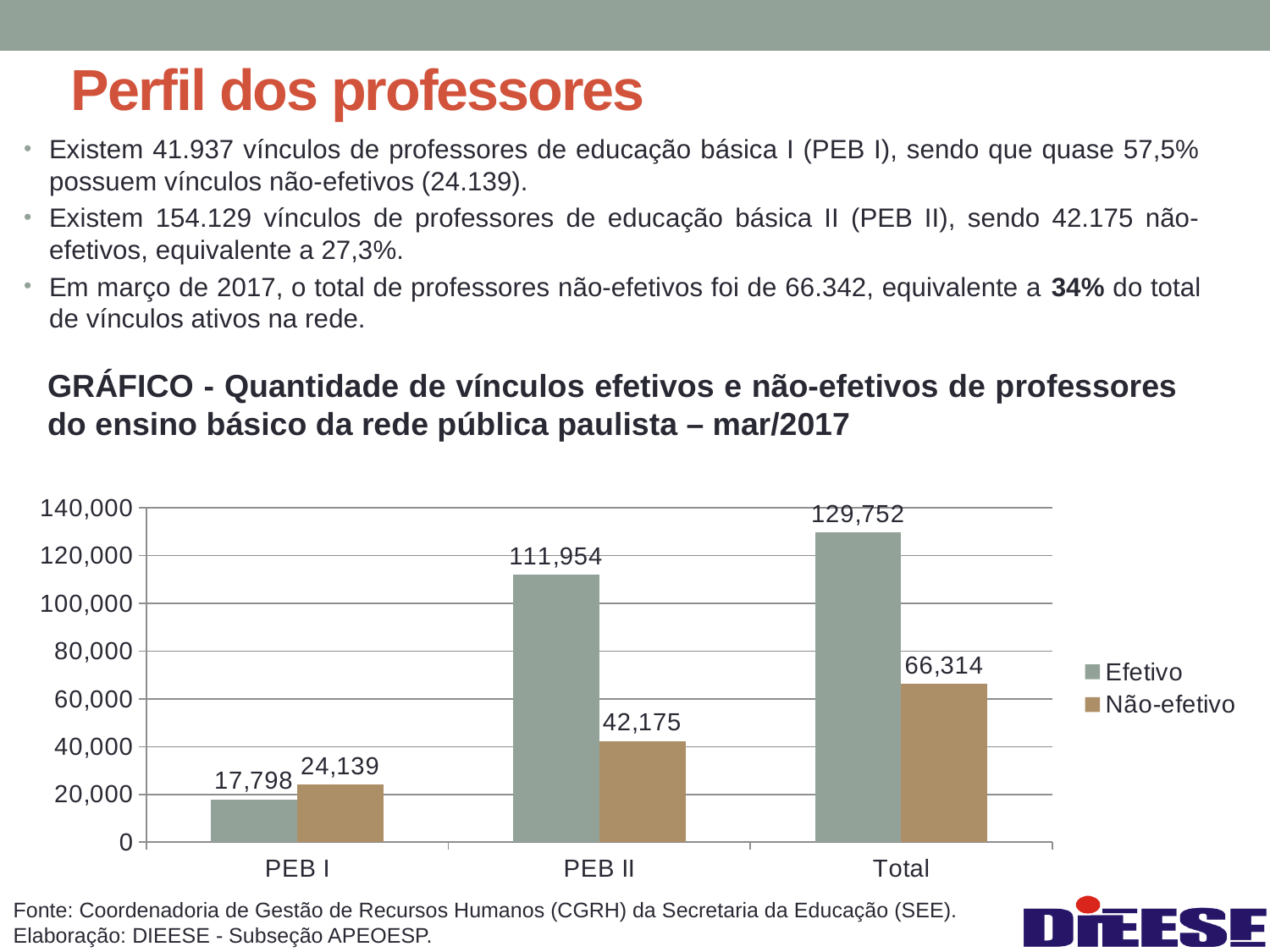
What are the two series named in the legend? Efetivo and Não-efetivo For PEB I, which is larger: the Efetivo bar or the Não-efetivo bar? Não-efetivo What is the difference between the Efetivo and Não-efetivo values for PEB II? 69,779 How many categories are shown on the x axis? 3 What kind of chart is shown on the slide? bar chart What is the value of the Não-efetivo bar for PEB I? 24,139 Which category has the highest Efetivo value? Total Is the Efetivo value for Total greater or less than 120,000? greater Which category has the lowest Não-efetivo value? PEB I What is the value of the Não-efetivo bar for Total? 66,314 How many series does the legend list? 2 What is the value of the Efetivo bar for PEB II? 111,954